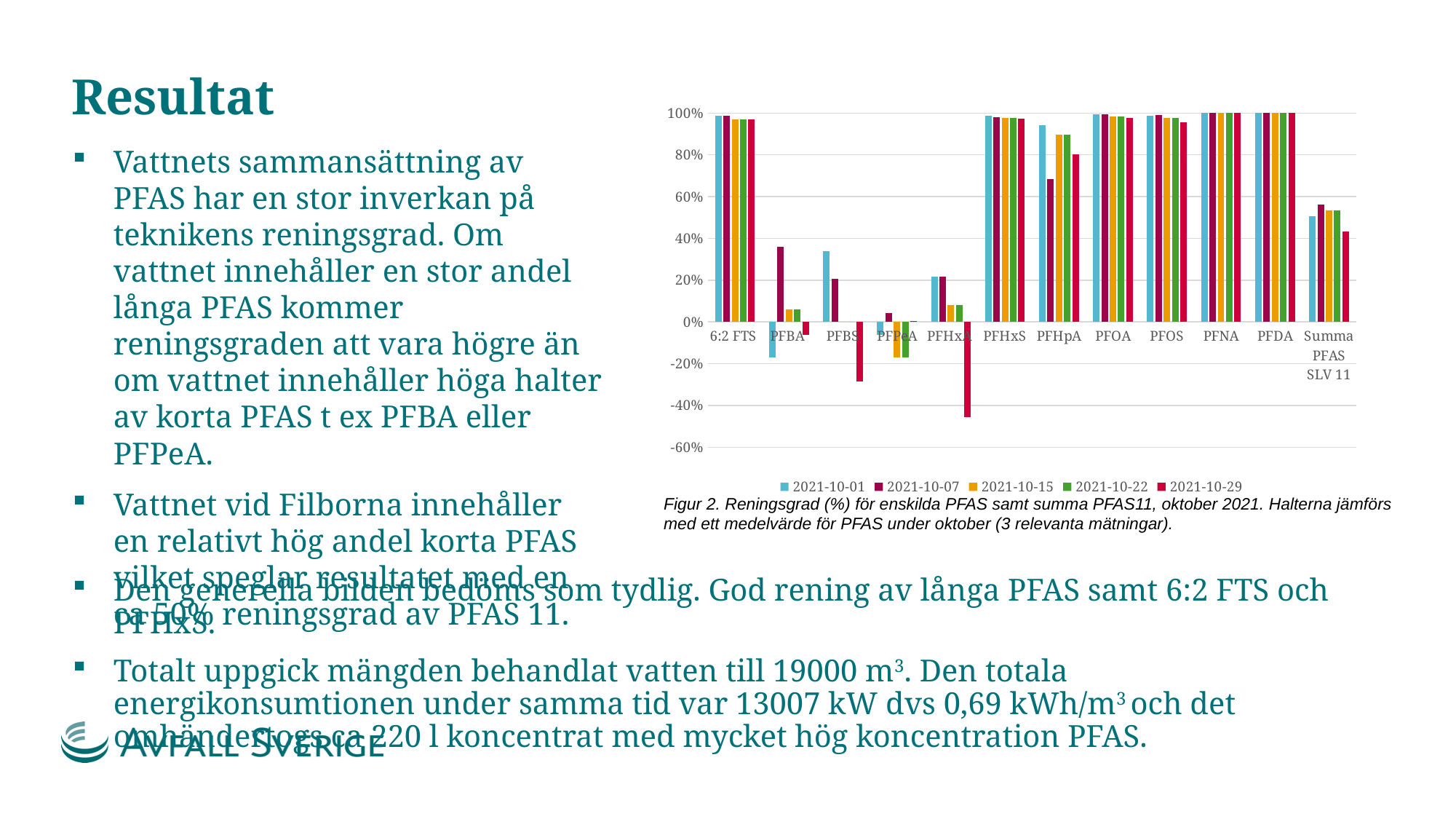
Is the value for PFHxA on 2021-10-29 greater or less than -40%? less Which category has the lowest bar in the chart? PFHxA How many series does the chart's legend list? 5 Which series is listed first in the chart's legend? 2021-10-01 For Summa PFAS SLV 11, which is larger: the value for 2021-10-07 or the value for 2021-10-29? 2021-10-07 Is the value for PFBA on 2021-10-07 greater or less than 20%? greater Is the value for Summa PFAS SLV 11 on 2021-10-01 greater or less than 40%? greater What kind of chart is shown on the slide? bar chart For PFHpA, which is larger: the value for 2021-10-01 or the value for 2021-10-07? 2021-10-01 Which is larger for 2021-10-07: the value for PFBA or the value for PFBS? PFBA How many categories are shown along the x axis of the chart? 12